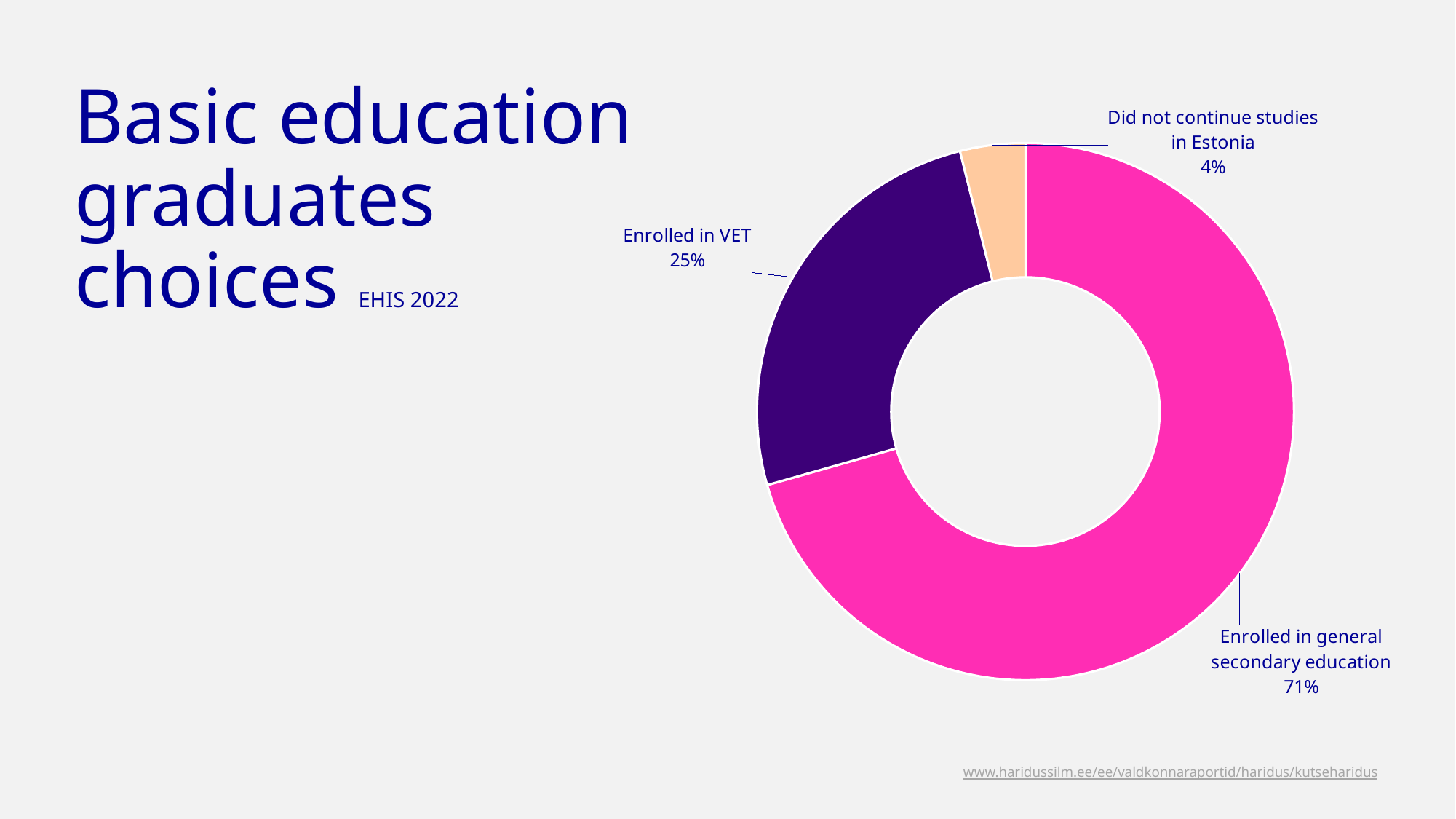
What percentage of basic education graduates did not continue studies in Estonia? 4% What percentage of basic education graduates enrolled in general secondary education? 71% What percentage of basic education graduates enrolled in VET? 25% How many categories are shown in the chart? 3 What is the title of the slide containing the chart? Basic education graduates choices Which is larger: the share enrolled in VET or the share that did not continue studies in Estonia? Enrolled in VET What is the difference in percentage points between those enrolled in VET and those who did not continue studies in Estonia? 21 What kind of chart is shown on the slide? Doughnut (pie) chart What is the difference in percentage points between those enrolled in general secondary education and those enrolled in VET? 46 Which category has the smallest share of the chart? Did not continue studies in Estonia What colour is the slice for those enrolled in VET? Dark purple Which category has the largest share of the chart? Enrolled in general secondary education